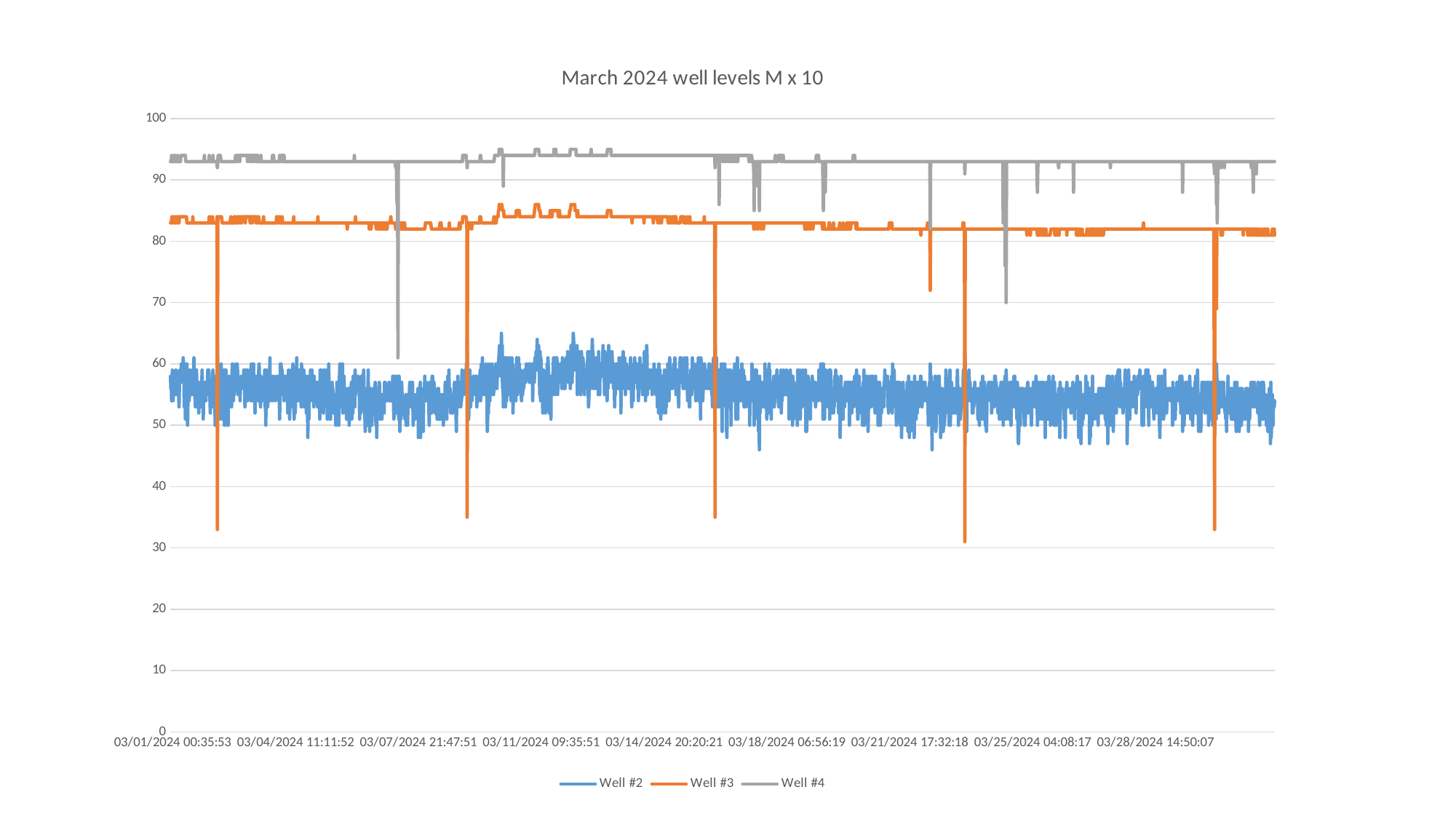
What kind of chart is shown on the slide? line chart Is the typical value for Well #3 greater or less than 80? greater Which series generally has larger values, Well #2 or Well #3? Well #3 Does the Well #4 line generally rise, fall, or stay flat across the month? stay flat How many series does the legend list? 3 What is the title of the chart? March 2024 well levels M x 10 Is the typical value for Well #4 greater or less than 90? greater Which series has the highest values across the month? Well #4 Which series is drawn in orange? Well #3 Which series has the lowest values across the month? Well #2 Are the lowest downward spikes of Well #3 greater or less than 40? less